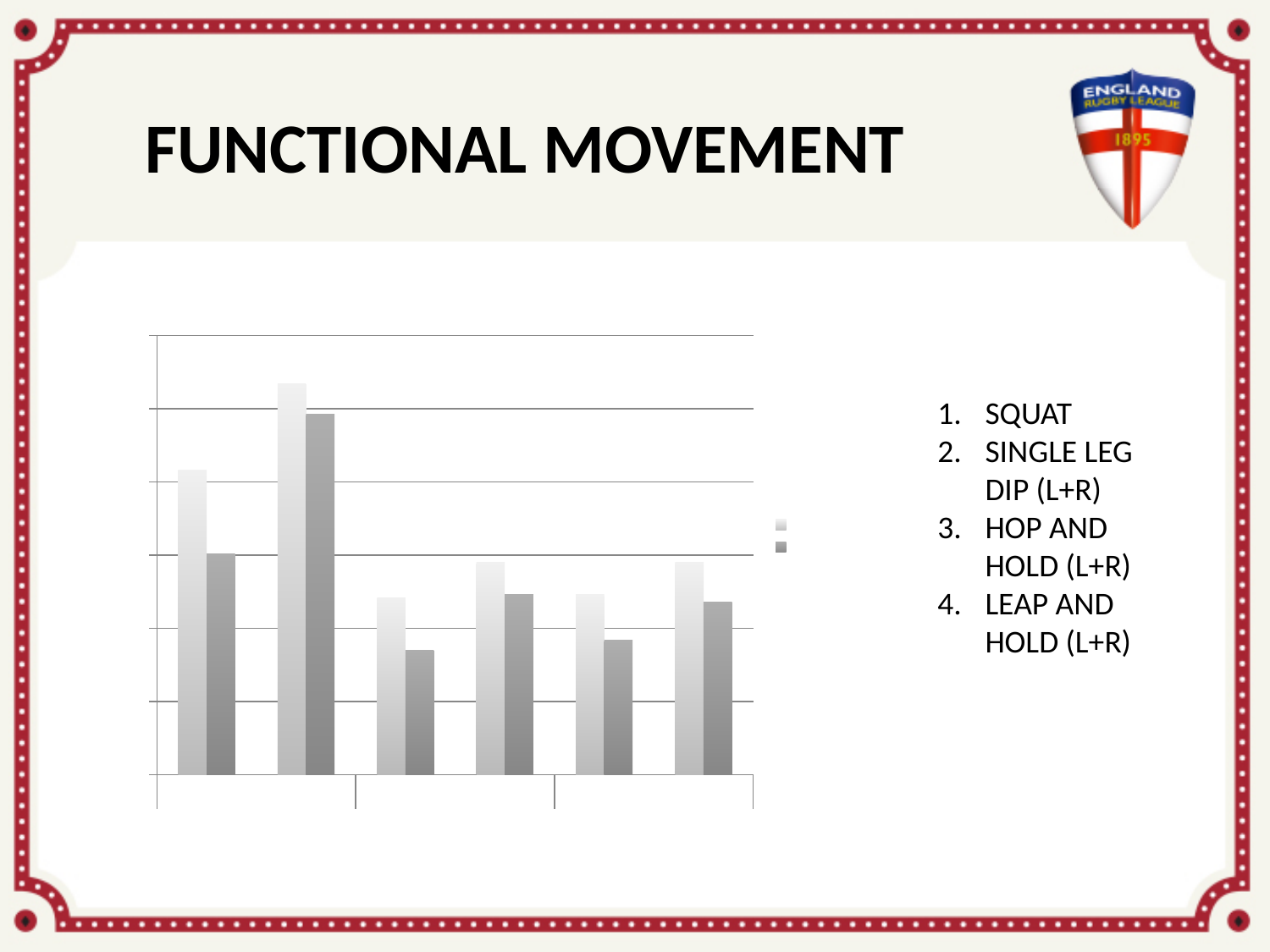
In the second pair of bars from the left, which bar is taller, the light grey one or the dark grey one? the light grey one Does the chart display any data labels on its bars? No Which pair of bars from the left contains the shortest bar in the chart? the third pair What two colours are used for the bars in the chart? light grey and dark grey In the fourth pair of bars from the left, is the light grey bar taller or shorter than the dark grey bar? taller Which pair of bars from the left contains the tallest bar in the chart? the second pair What kind of chart is shown on the slide? bar chart How many bars in total are plotted in the chart? 12 How many pairs of bars (categories) are plotted in the chart? 6 How many series does the chart's legend list? 2